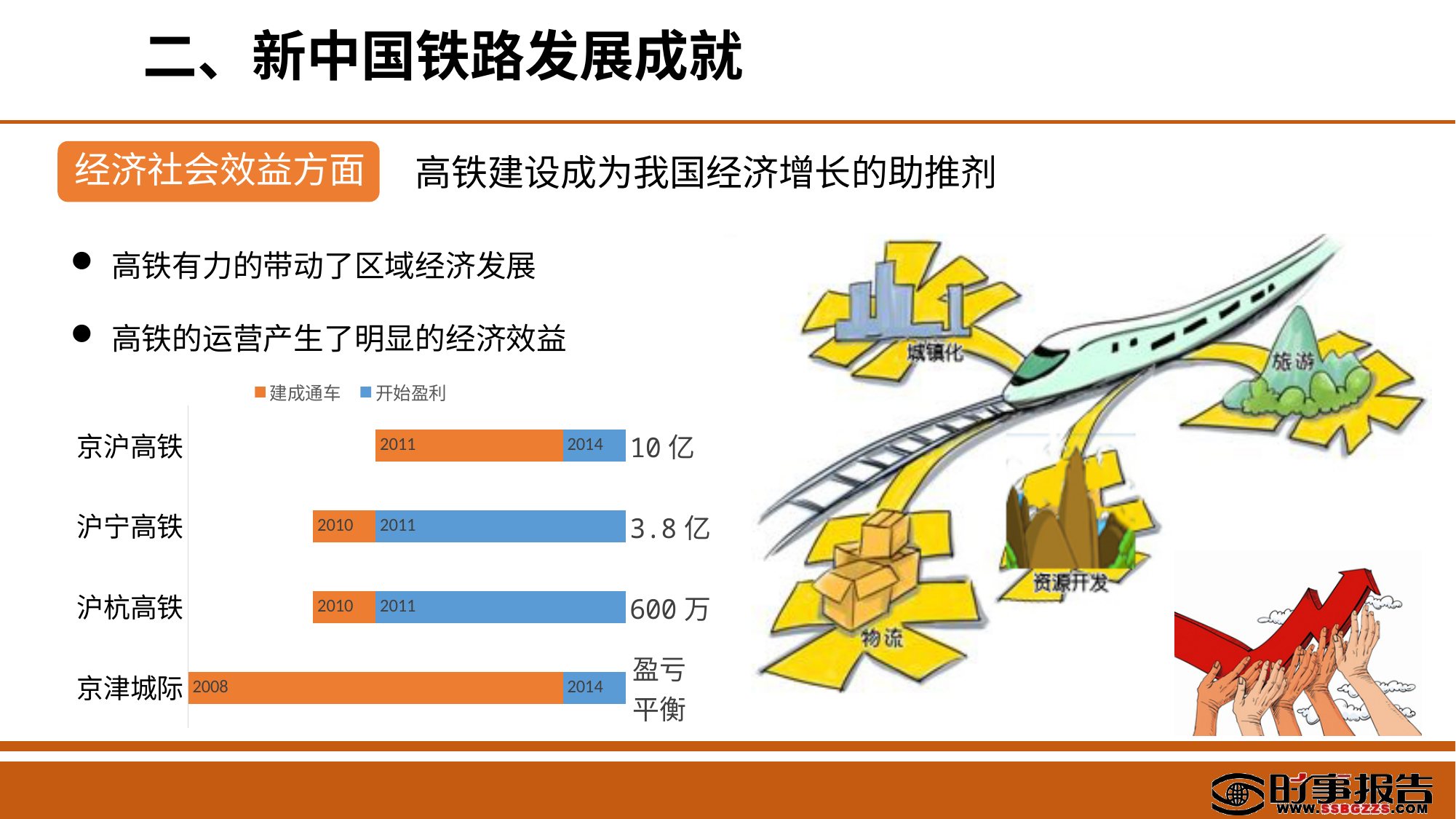
In which year did 京沪高铁 开始盈利 according to the chart? 2014 How many years passed between 建成通车 and 开始盈利 for 京津城际? 6 In which year did 京沪高铁 建成通车 according to the chart? 2011 What kind of chart is shown on the slide? bar chart How many railway lines (categories) are shown in the chart? 4 Which railway line has the earliest 建成通车 year in the chart? 京津城际 What are the two legend entries of the chart? 建成通车, 开始盈利 Which line took longer from 建成通车 to 开始盈利, 京沪高铁 or 沪宁高铁? 京沪高铁 How many series does the chart legend list? 2 In which year did 沪杭高铁 开始盈利 according to the chart? 2011 What profit figure is annotated next to the 沪宁高铁 bar? 3.8 亿 In which year did 京津城际 建成通车 according to the chart? 2008